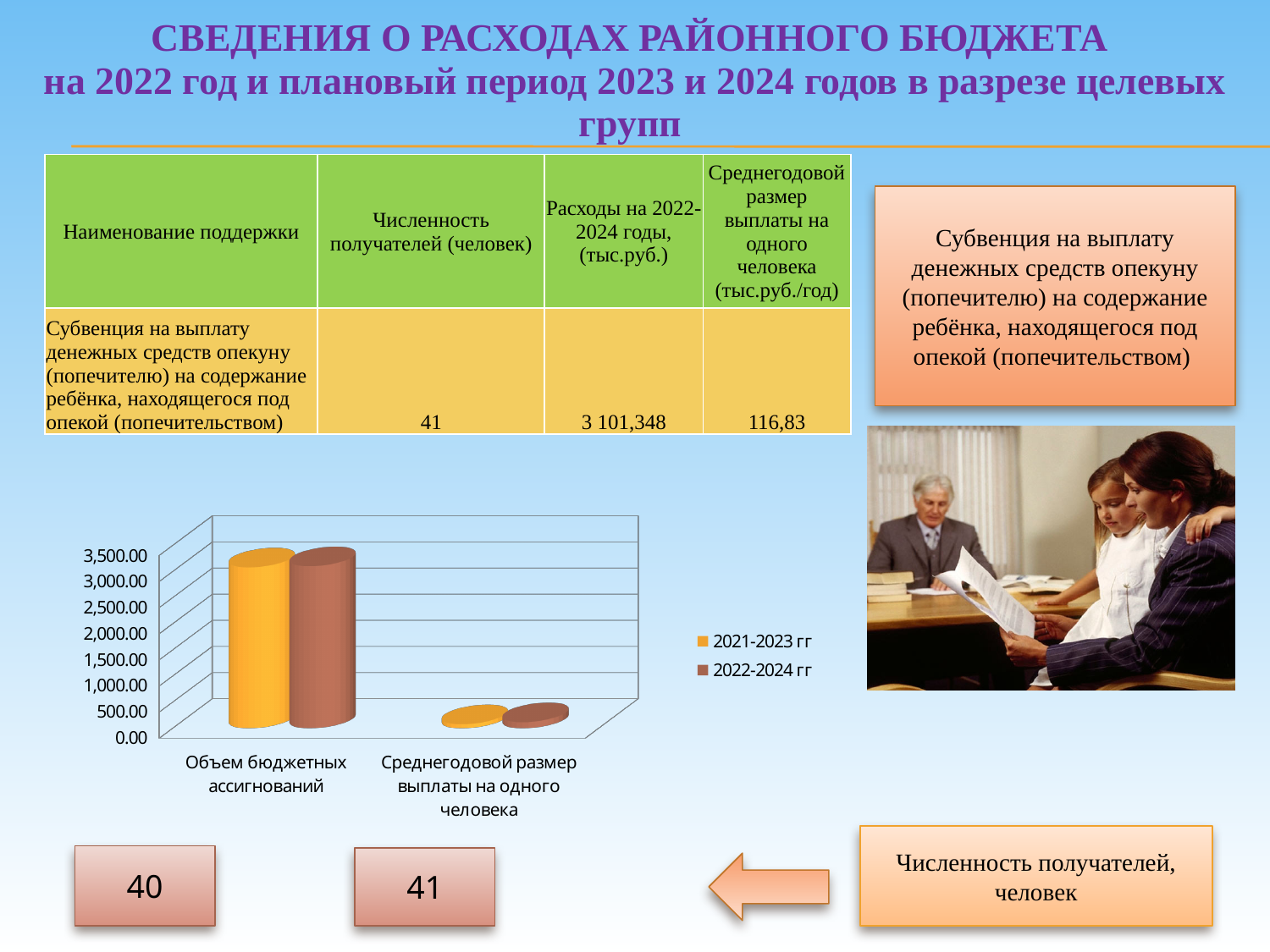
Is the value for Среднегодовой размер выплаты на одного человека in the 2022-2024 гг series greater or less than 500.00? less What kind of chart is shown on the slide? bar chart What is the highest value shown on the chart's vertical axis? 3,500.00 Which category has the highest bars in the chart? Объем бюджетных ассигнований Is the value for Объем бюджетных ассигнований in the 2022-2024 гг series greater or less than 2,500.00? greater What colour represents the 2022-2024 гг series in the chart? brown What are the two series named in the chart legend? 2021-2023 гг and 2022-2024 гг Which is larger in the 2022-2024 гг series: Объем бюджетных ассигнований or Среднегодовой размер выплаты на одного человека? Объем бюджетных ассигнований Which category has the lowest bars in the chart? Среднегодовой размер выплаты на одного человека How many categories are shown on the x axis of the chart? 2 Is the value for Объем бюджетных ассигнований in the 2021-2023 гг series greater or less than 3,500.00? less How many series does the chart legend list? 2